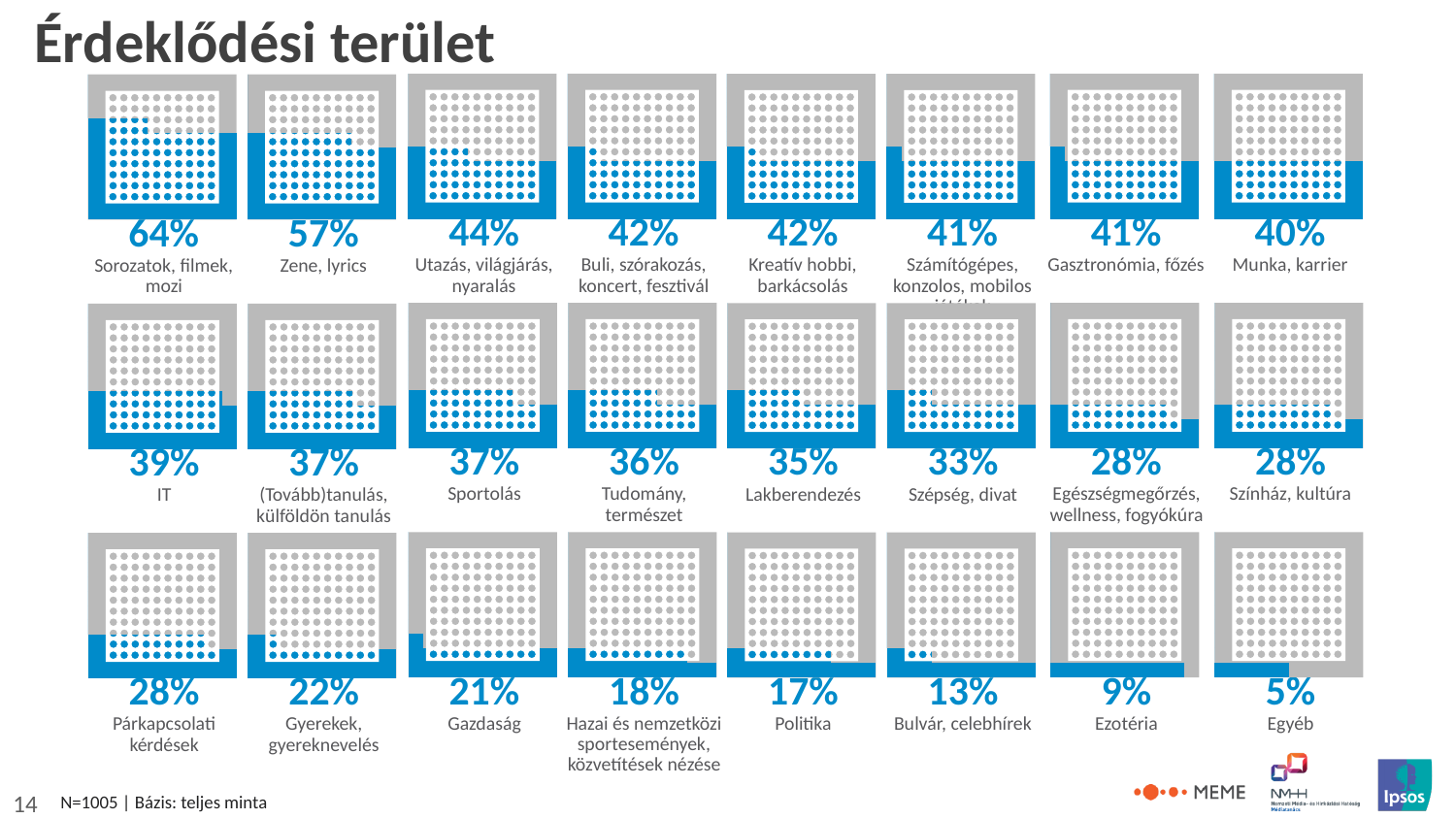
How many interest areas are shown on the slide? 24 What kind of chart is used to show each percentage on the slide? Pictograph (waffle chart of dots) What percentage is shown for Politika? 17% Which interest area has the lowest percentage on the slide? Egyéb What percentage is shown for Gasztronómia, főzés? 41% What is the difference in percentage points between Zene, lyrics and Sportolás? 20 Which interest area has the highest percentage on the slide? Sorozatok, filmek, mozi Which has a higher percentage, Lakberendezés or Gazdaság? Lakberendezés What is the difference in percentage points between Ezotéria and Egyéb? 4 What is the sample size (N) stated at the bottom of the slide? N=1005 What is the title of the slide? Érdeklődési terület What percentage is shown for Sorozatok, filmek, mozi? 64%